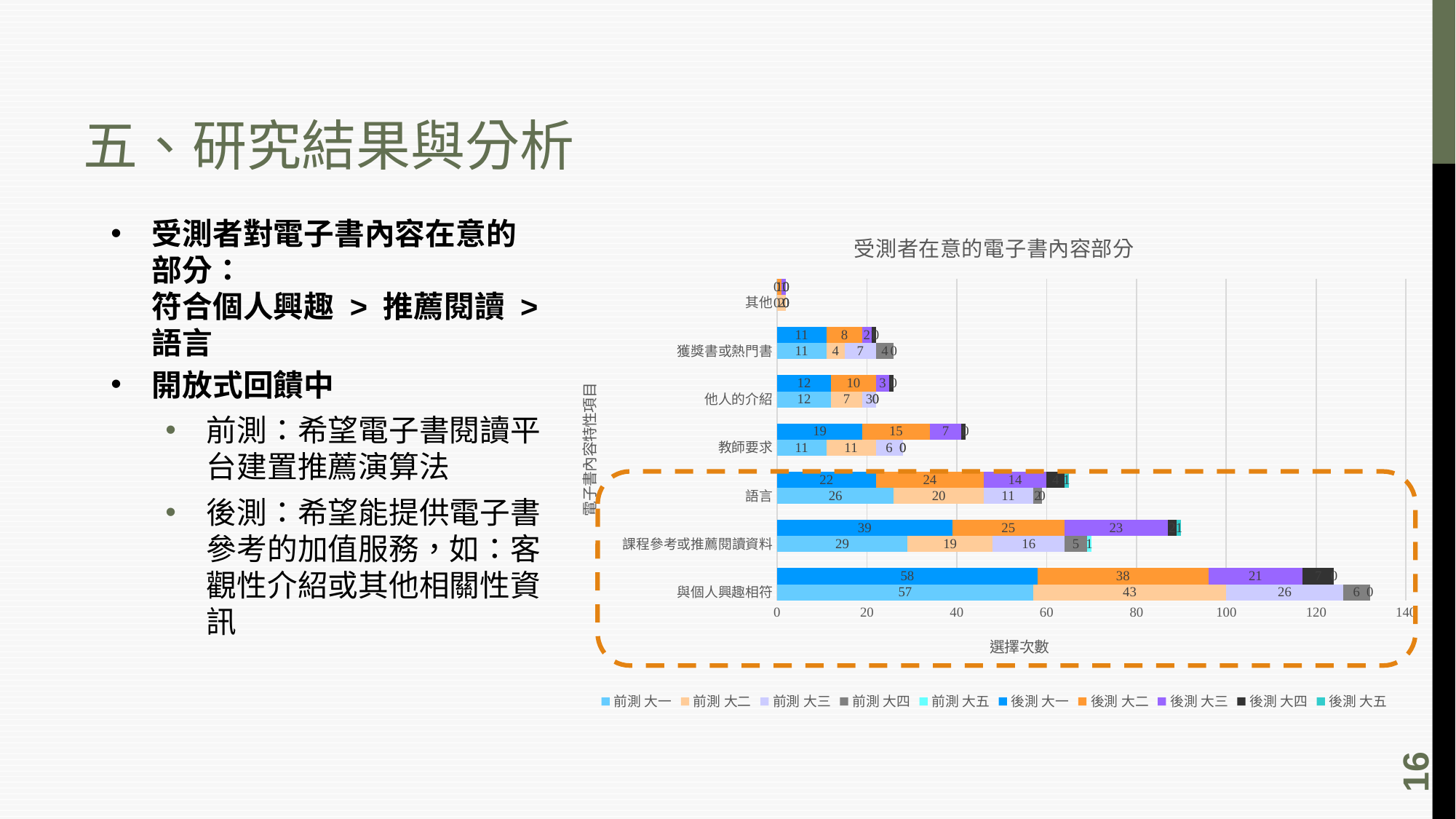
Which category has the longest bars in the chart? 與個人興趣相符 How many categories are shown on the vertical axis of the chart? 7 What is the difference between 後測 大一 and 前測 大一 for 課程參考或推薦閱讀資料? 10 What is the value of 前測 大一 for 語言? 26 What is the value of 後測 大一 for 課程參考或推薦閱讀資料? 39 Is the total length of the 前測 bar for 與個人興趣相符 greater or less than 120? greater How many series does the chart legend list? 10 For 與個人興趣相符, which is larger: 前測 大二 or 後測 大二? 前測 大二 What is the value of 前測 大二 for 與個人興趣相符? 43 What is the value of 後測 大一 for 與個人興趣相符? 58 What is the title of the chart? 受測者在意的電子書內容部分 What type of chart is shown on the slide? bar chart